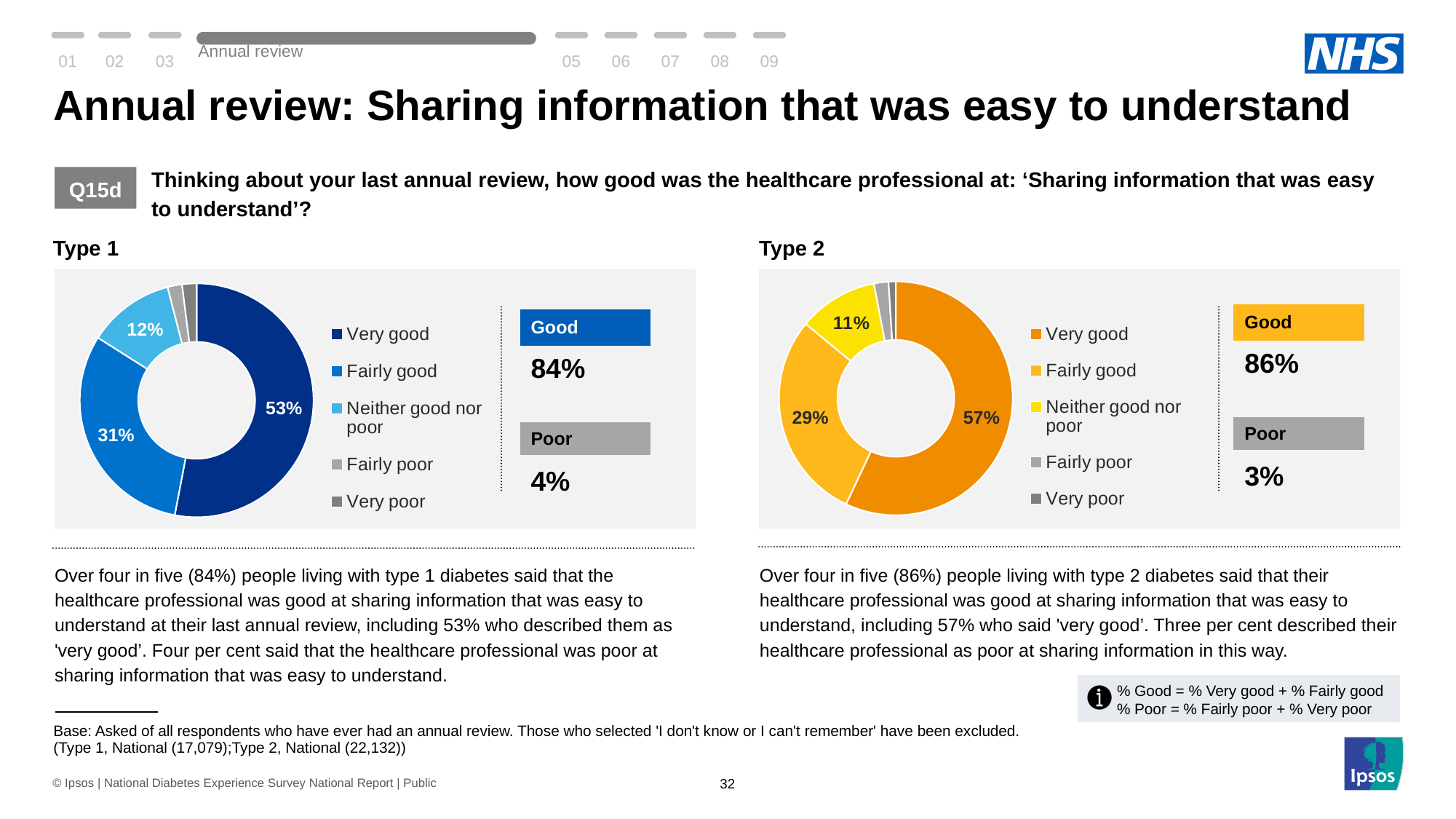
In the Type 1 chart, what is the difference in percentage points between 'Very good' and 'Fairly good'? 22 percentage points In the Type 2 chart, what is the combined 'Good' percentage shown? 86% In the Type 1 chart, what percentage of respondents said 'Very good'? 53% Which is larger: the 'Very good' share in the Type 1 chart or the 'Very good' share in the Type 2 chart? Type 2 In the Type 2 chart, which response category has the largest share? Very good How many response categories does the legend of the Type 1 chart list? 5 What kind of chart is used for Type 1 and Type 2? Donut (pie) chart In the Type 1 chart, what is the combined 'Poor' percentage shown? 4% In the Type 2 chart, what share of the pie is 'Neither good nor poor'? 11% What colour represents 'Very good' in the Type 2 chart? Orange In the Type 1 chart, what percentage said 'Neither good nor poor'? 12% In the Type 2 chart, what percentage of respondents said 'Fairly good'? 29%